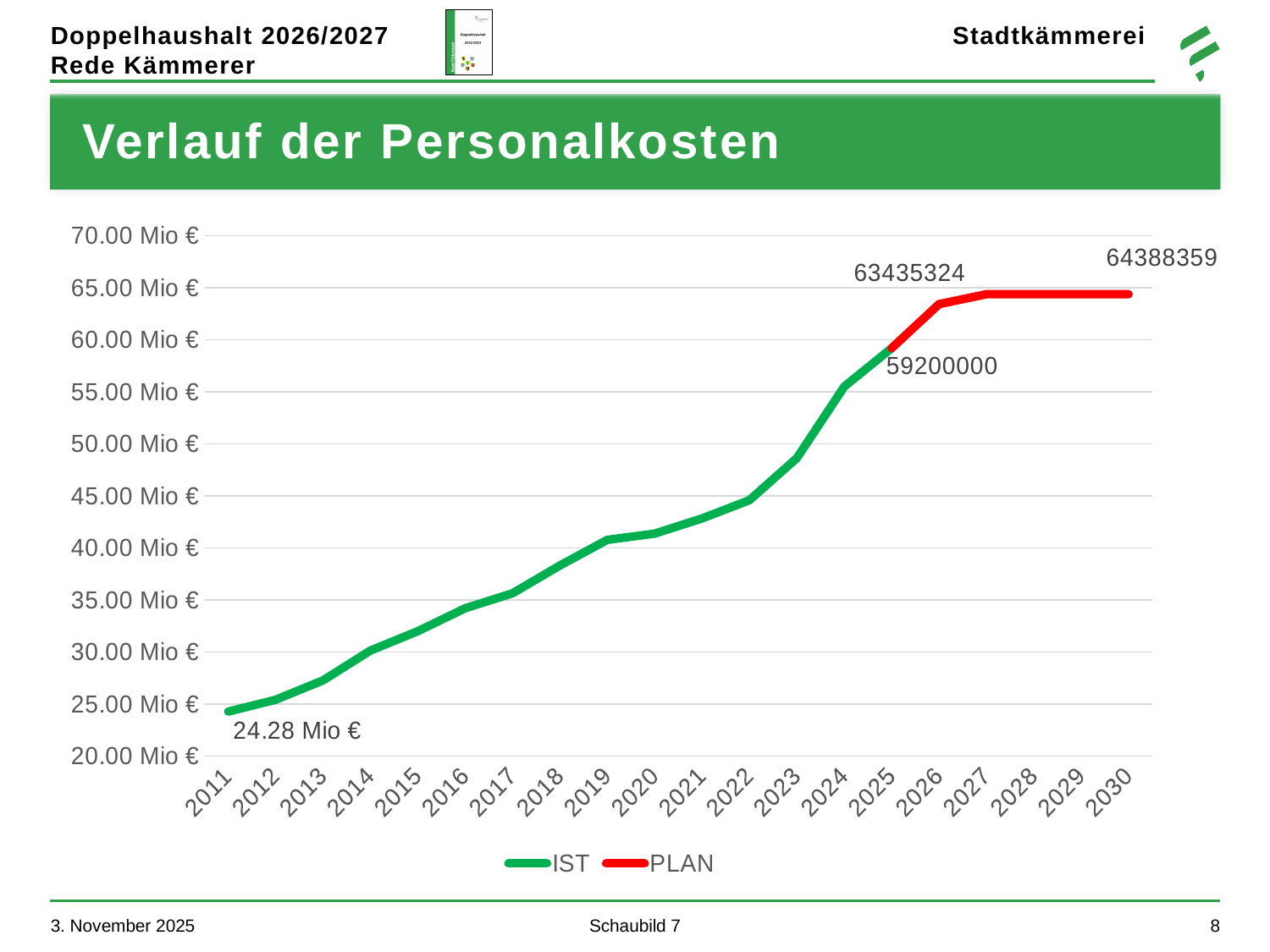
Which year has the lowest value? 2011 Do the personnel costs rise or fall from 2011 to 2030? rise Which series is drawn in red? PLAN What is the difference between the values for 2030 and 2026? 953035 How many series does the legend list? 2 How many years are shown on the x axis? 20 What is the value for 2030? 64388359 What is the value for 2011? 24.28 Mio € What kind of chart is shown on the slide? line chart What is the value for 2025? 59200000 Is the value for 2023 greater or less than 50.00 Mio €? less What is the value for 2026? 63435324